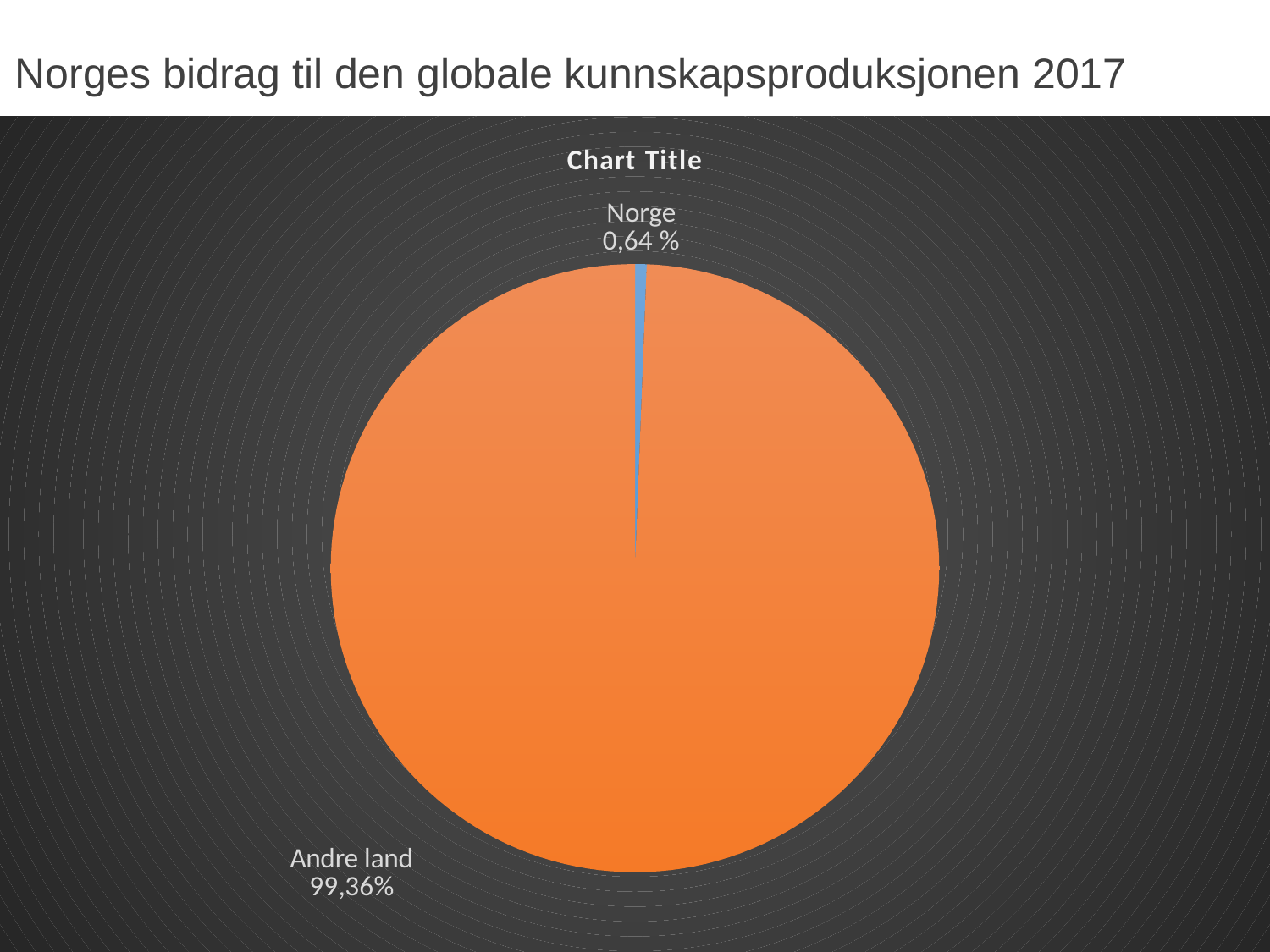
Which slice of the pie is the smallest? Norge Which slice of the pie is the largest? Andre land What colour is the Andre land slice? orange What kind of chart is shown on the slide? pie chart What is the difference between the share for Andre land and the share for Norge? 98,72 percentage points What share of the pie does Norge represent? 0,64 % How many slices does the pie chart have? 2 What is the title printed above the pie chart? Chart Title What share of the pie does Andre land represent? 99,36% Which is larger, the share for Norge or the share for Andre land? Andre land